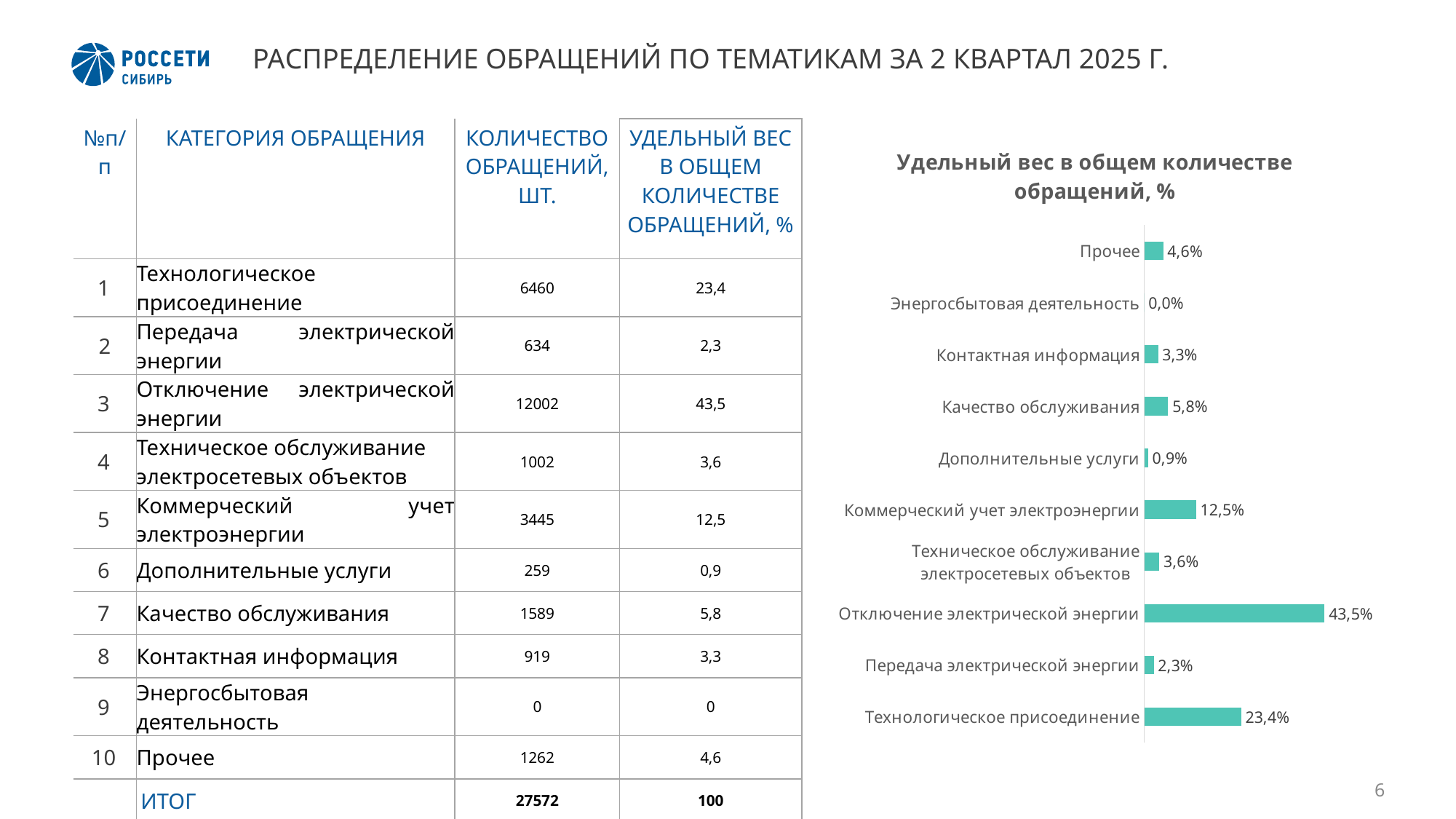
What is the value for Технологическое присоединение in the chart? 23,4% Which category has the highest value in the chart? Отключение электрической энергии What is the value for Дополнительные услуги in the chart? 0,9% What is the value for Коммерческий учет электроэнергии in the chart? 12,5% What is the difference between the values for Коммерческий учет электроэнергии and Качество обслуживания? 6,7% How many categories are shown in the chart? 10 Which category has the lowest value in the chart? Энергосбытовая деятельность What is the difference between the values for Отключение электрической энергии and Технологическое присоединение? 20,1% What is the value for Отключение электрической энергии in the chart? 43,5% What is the title of the chart? Удельный вес в общем количестве обращений, % What kind of chart is shown on the slide? Bar chart Which is larger: the value for Качество обслуживания or the value for Контактная информация? Качество обслуживания